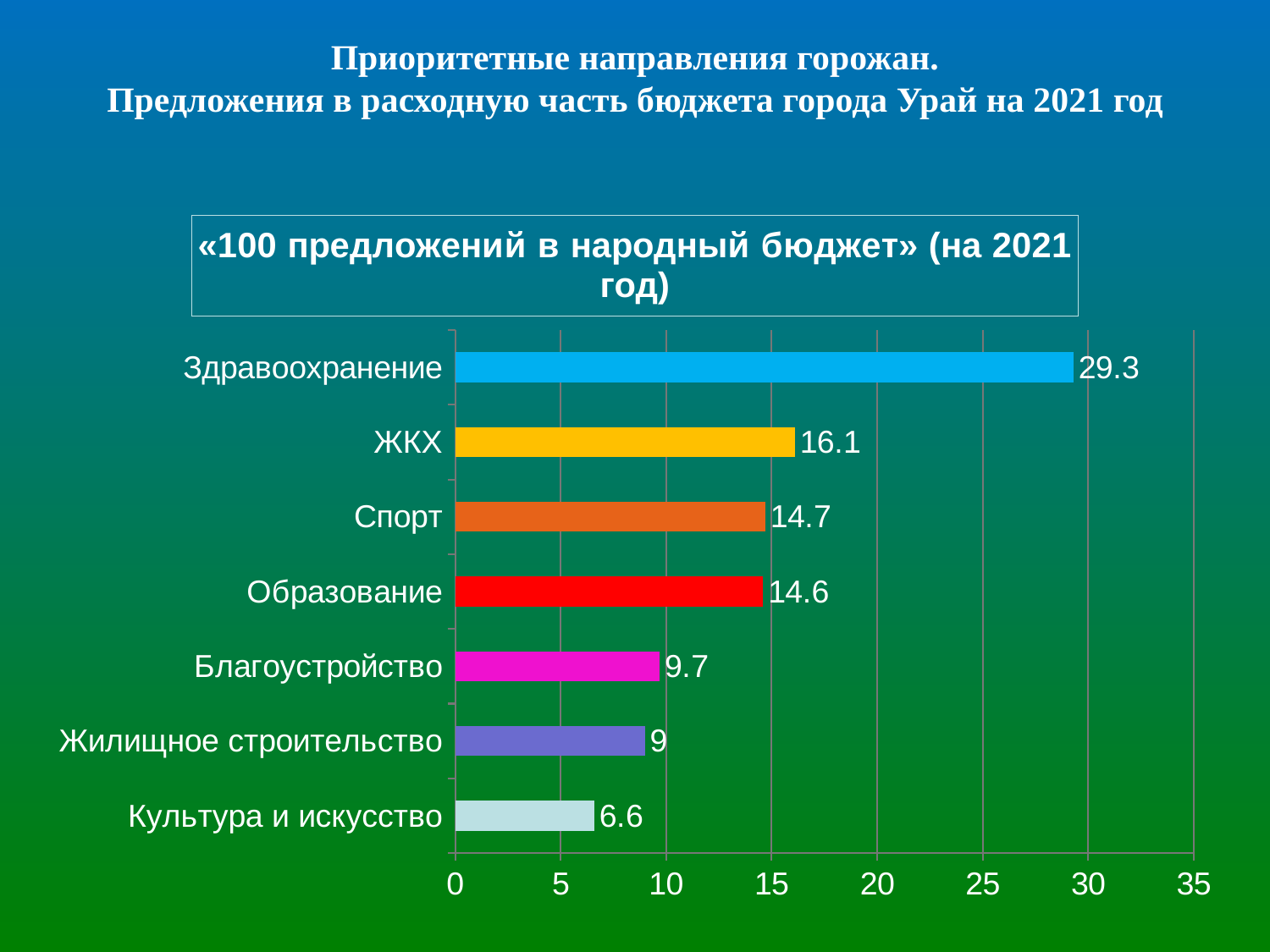
How many categories are shown in the chart? 7 What is the value for Благоустройство? 9.7 Is the value for Образование greater or less than 10? greater Which is larger, the value for ЖКХ or the value for Спорт? ЖКХ What is the value for Здравоохранение? 29.3 What is the difference between the values for Здравоохранение and ЖКХ? 13.2 Which category has the highest value? Здравоохранение Which category has the lowest value? Культура и искусство What is the difference between the values for Благоустройство and Жилищное строительство? 0.7 What is the value for ЖКХ? 16.1 What is the value for Культура и искусство? 6.6 What kind of chart is shown on the slide? bar chart